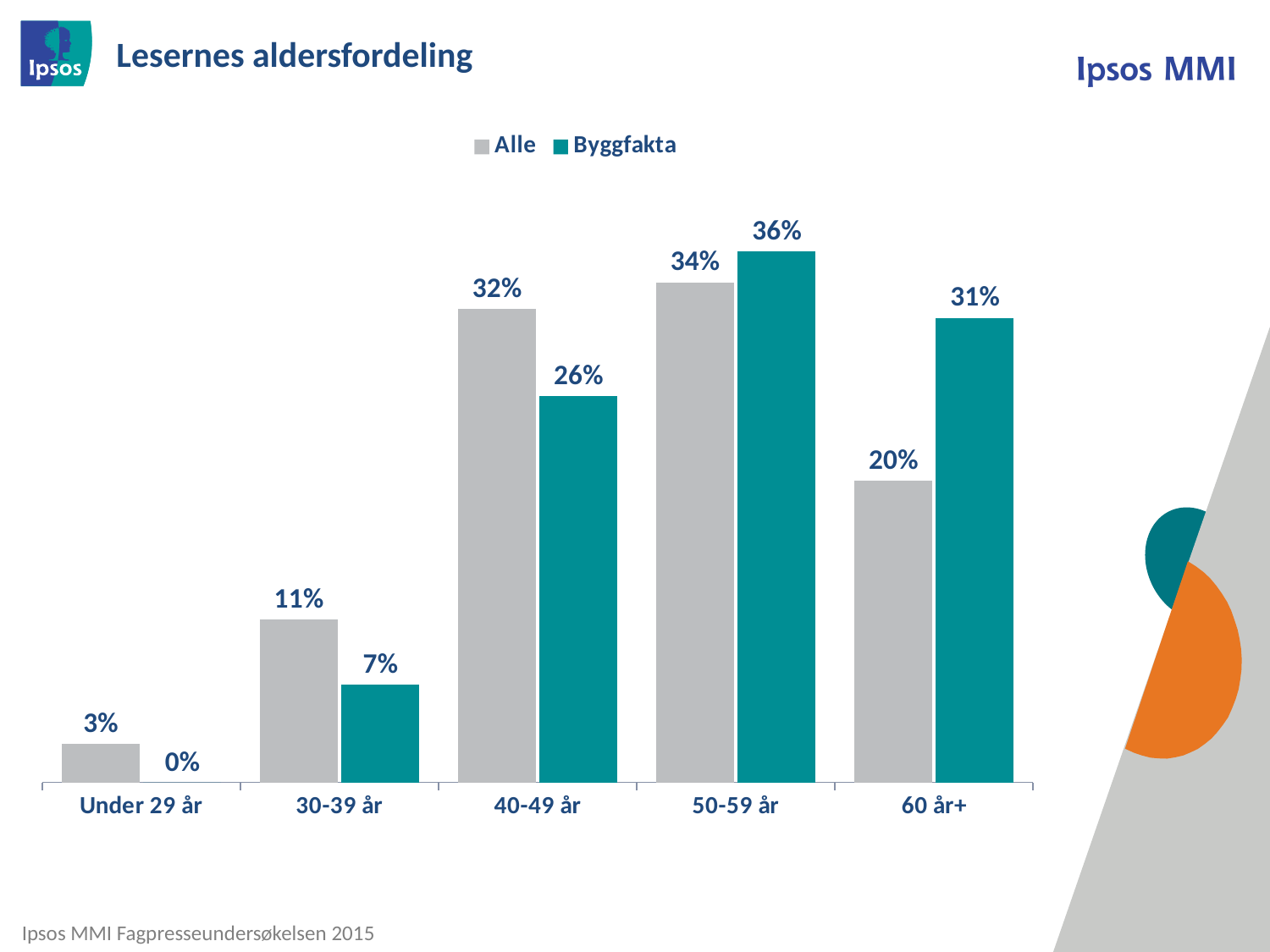
What kind of chart is shown on the slide? Bar chart Which age category has the highest value for Byggfakta? 50-59 år Which age category has the lowest value for Alle? Under 29 år Which series is shown in grey in the legend? Alle Which is larger in the 30-39 år category, Alle or Byggfakta? Alle What is the title of the chart? Lesernes aldersfordeling What is the difference between Byggfakta and Alle in the 60 år+ category? 11% What is the value for Alle in the 60 år+ category? 20% How many age categories are shown on the x axis? 5 How many series does the legend list? 2 What is the value for Byggfakta in the 40-49 år category? 26% What is the value for Byggfakta in the Under 29 år category? 0%